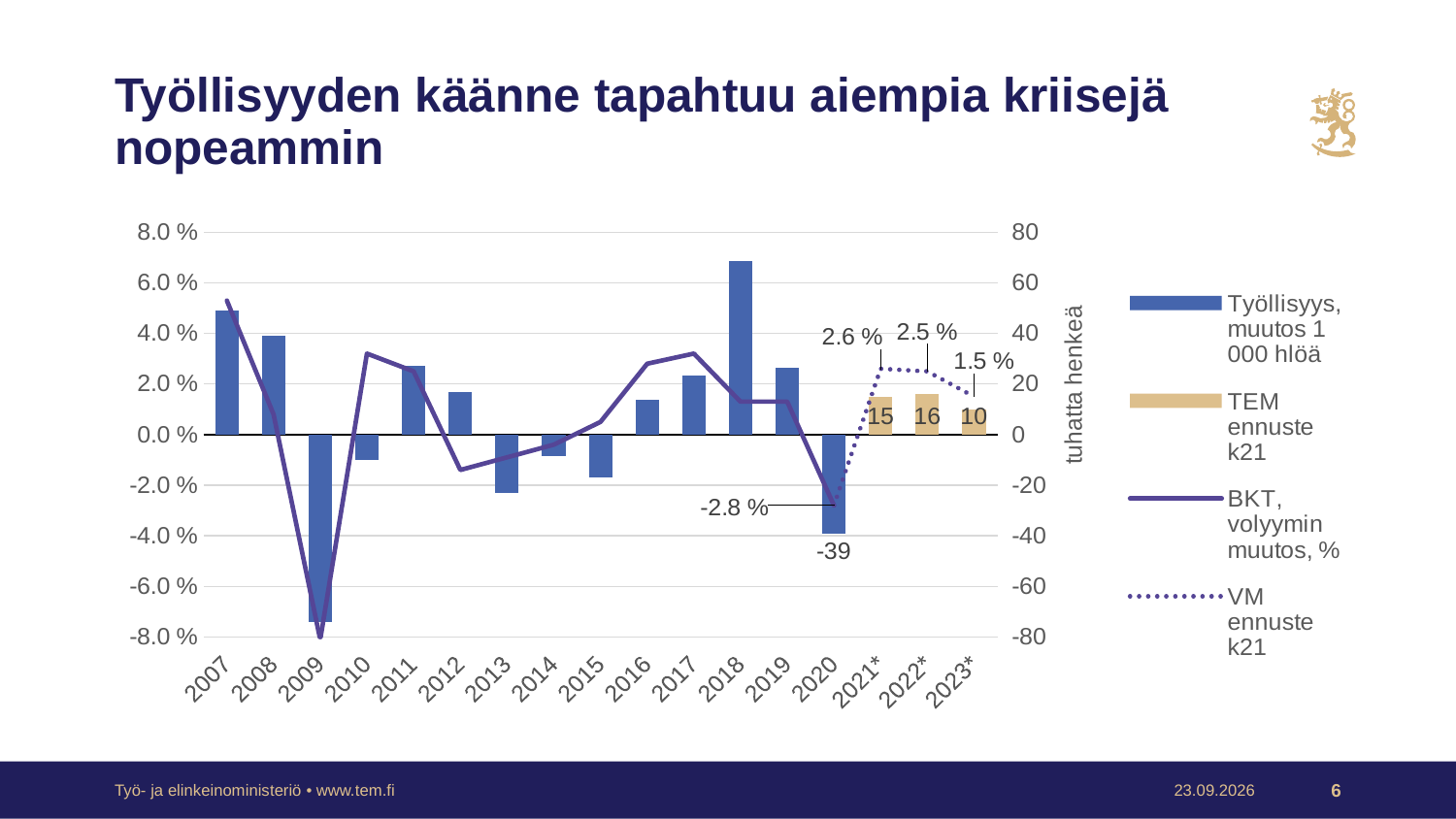
How many years are shown on the x axis? 17 Do the VM ennuste k21 values rise or fall from 2021* to 2023*? fall How many series does the legend list? 4 Which year has the larger VM ennuste k21 value, 2021* or 2023*? 2021* What is the BKT, volyymin muutos value for 2020? -2.8 % In which year is the Työllisyys, muutos 1 000 hlöä bar lowest? 2009 What is the Työllisyys, muutos 1 000 hlöä value for 2020? -39 What is the TEM ennuste k21 value for 2021*? 15 What is the VM ennuste k21 value for 2021*? 2.6 % What is the TEM ennuste k21 value for 2023*? 10 Is the Työllisyys, muutos 1 000 hlöä value for 2018 greater or less than 60? greater What is the difference between the TEM ennuste k21 values for 2022* and 2023*? 6